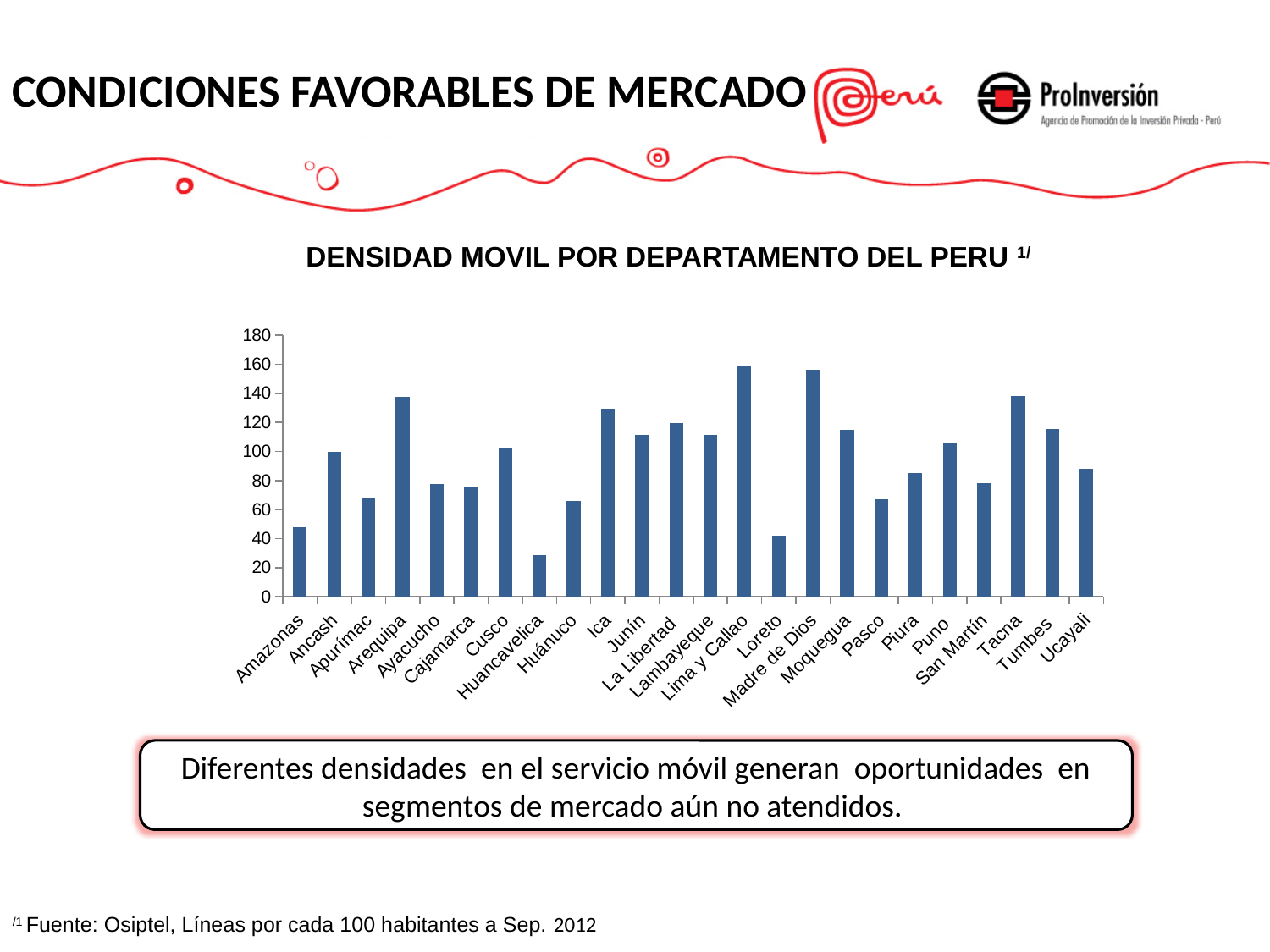
Which department has the lowest mobile density in the chart? Huancavelica What is the title of the chart? DENSIDAD MOVIL POR DEPARTAMENTO DEL PERU Is the value for Ucayali greater or less than 100? less Is the value for Huancavelica greater or less than 40? less Is the value for Amazonas greater or less than 60? less Which has a higher mobile density, Ica or Junín? Ica How many departments are shown on the x axis of the chart? 24 What kind of chart is shown on the slide? bar chart Which has a higher mobile density, Arequipa or Ayacucho? Arequipa Which has a higher mobile density, Pasco or Piura? Piura